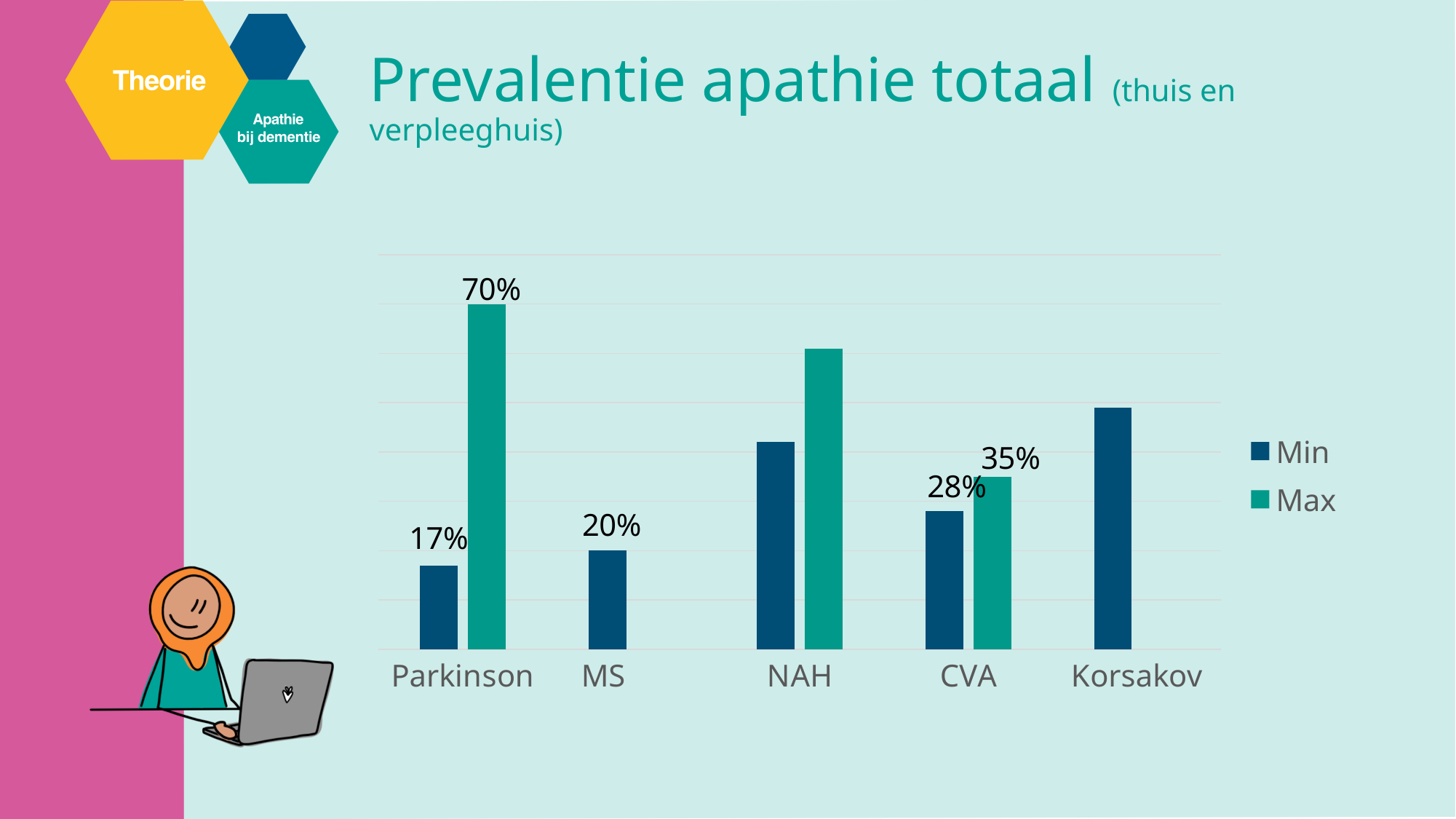
Which category has the highest Max bar? Parkinson What is the difference between the Max and Min values for CVA? 7 percentage points What is the difference between the Max and Min values for Parkinson? 53 percentage points What is the Max value for CVA? 35% What is the Max value for Parkinson? 70% What is the Min value for MS? 20% How many categories are shown on the x axis? 5 Which has the larger Min bar, NAH or Korsakov? Korsakov What is the Min value for Parkinson? 17% Which category has the lowest Min bar? Parkinson How many series does the legend list? 2 What kind of chart is shown on the slide? Bar chart